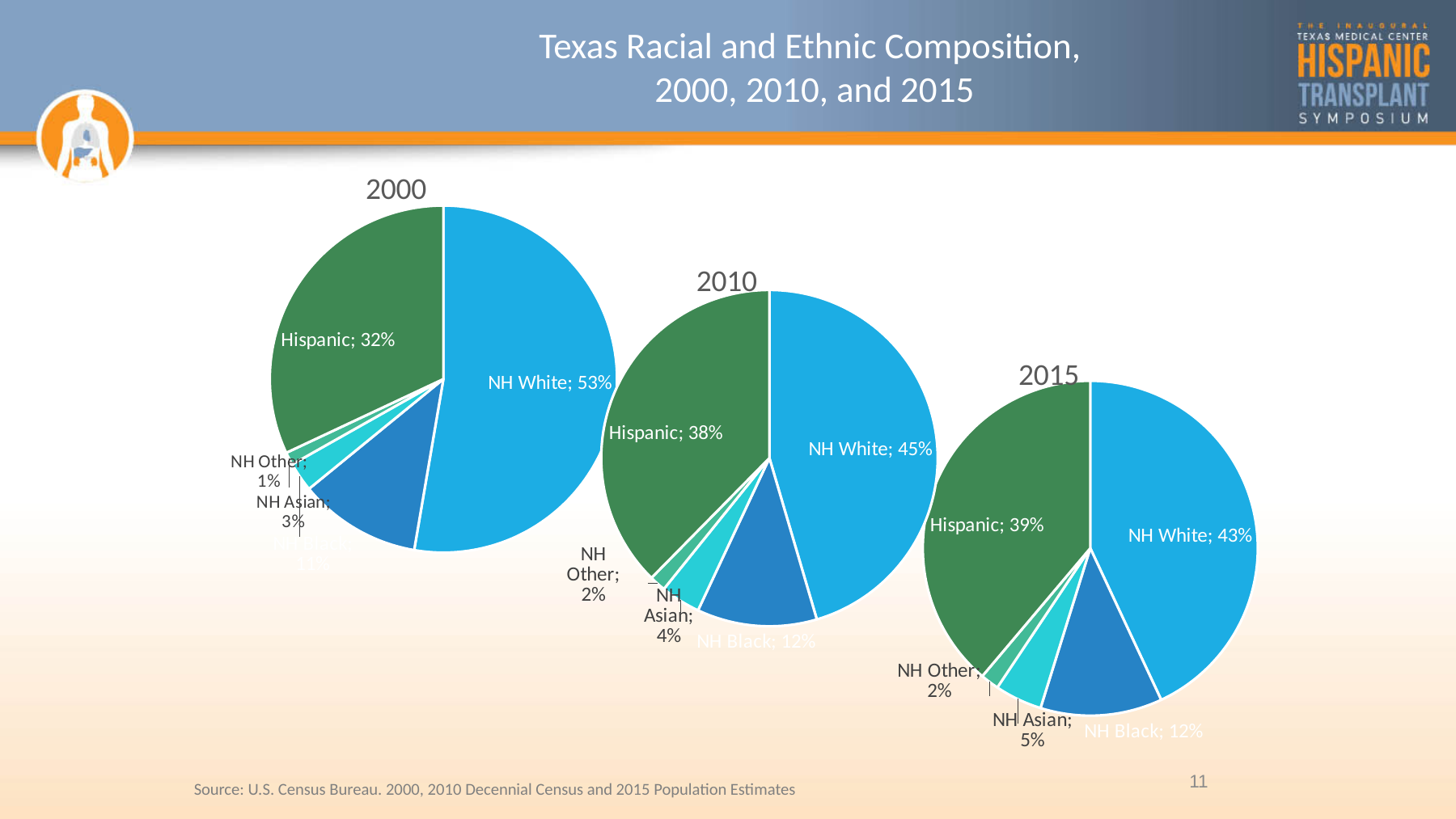
In the 2010 pie chart, what share of the population is Hispanic? 38% In the 2000 pie chart, which group has the largest share? NH White In the 2010 pie chart, which is larger, the NH White share or the Hispanic share? NH White In the 2000 pie chart, what share of the population is NH White? 53% In the 2000 pie chart, which group has the smallest share? NH Other What kind of charts are shown on the slide? Pie charts In the 2015 pie chart, what is the difference between the NH White share and the Hispanic share? 4% In the 2015 pie chart, what share of the population is NH Asian? 5% In the 2015 pie chart, what share of the population is NH White? 43% How many slices does the 2010 pie chart have? 5 Across the 2000, 2010 and 2015 pie charts, does the NH White share rise or fall over time? Fall How many pie charts are on the slide? 3